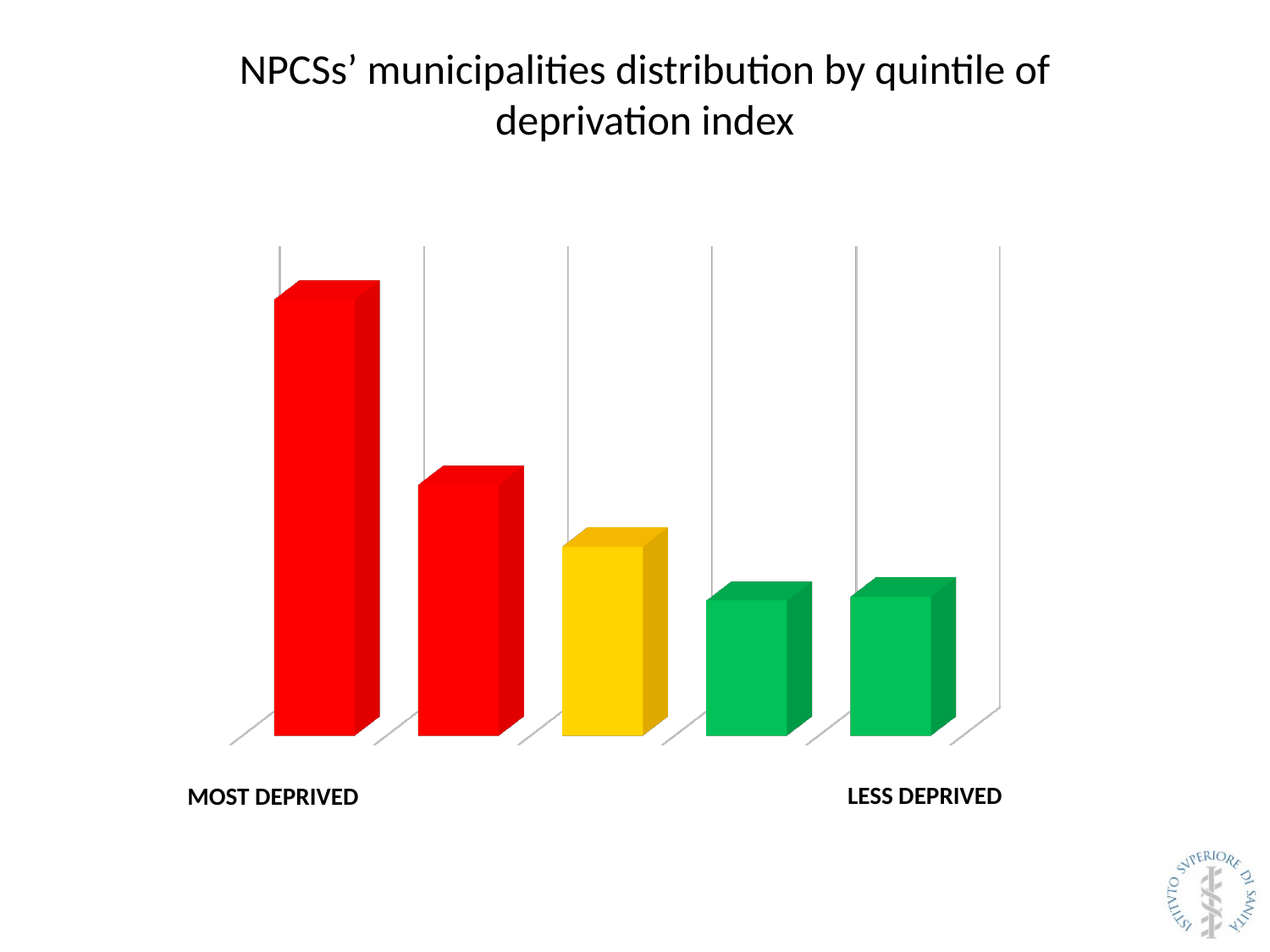
What kind of chart is shown on the slide? Bar chart What is the title of the chart? NPCSs' municipalities distribution by quintile of deprivation index Which end of the x axis has the tallest bar, the most deprived or the less deprived end? Most deprived Which bar is taller, the second bar or the third (yellow) bar? The second bar Do the bar heights rise or fall moving from the most deprived quintile to the less deprived quintile? Fall Which bar is taller, the first bar (most deprived) or the second bar? The first bar (most deprived) What label appears under the right end of the x axis? LESS DEPRIVED What colour is the middle (third) bar? Yellow How many bars are plotted in the chart? 5